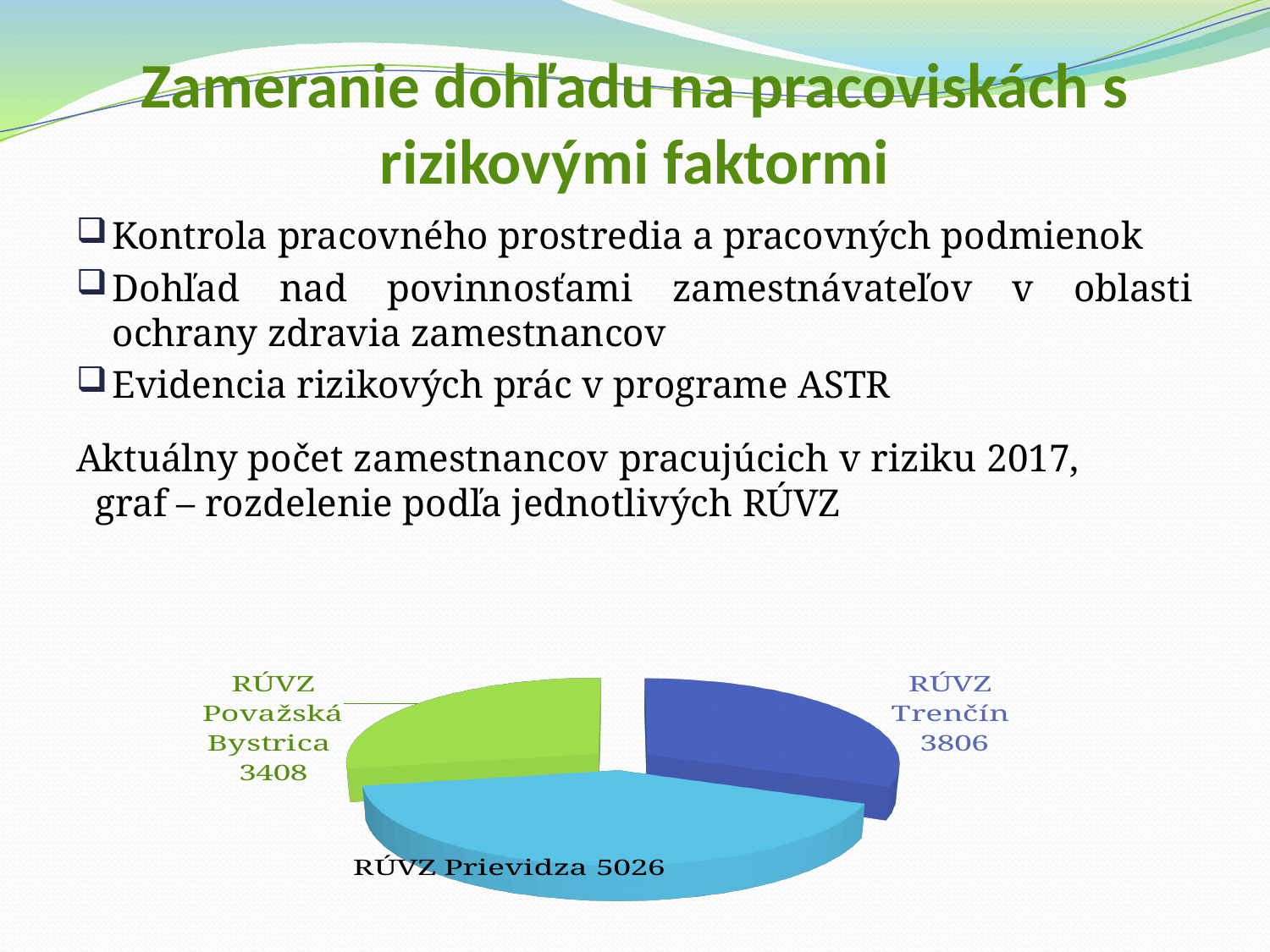
Which RÚVZ has the smallest slice in the pie chart? RÚVZ Považská Bystrica What is the difference between the values for RÚVZ Prievidza and RÚVZ Trenčín? 1220 Which is larger, the value for RÚVZ Trenčín or the value for RÚVZ Považská Bystrica? RÚVZ Trenčín How many slices does the pie chart have? 3 What colour is the slice for RÚVZ Považská Bystrica? Green What kind of chart is shown on the slide? Pie chart What is the difference between the values for RÚVZ Trenčín and RÚVZ Považská Bystrica? 398 What is the value for RÚVZ Prievidza in the pie chart? 5026 What is the value for RÚVZ Považská Bystrica in the pie chart? 3408 Which RÚVZ has the largest slice in the pie chart? RÚVZ Prievidza What is the total of all three values shown in the pie chart? 12240 What is the value for RÚVZ Trenčín in the pie chart? 3806